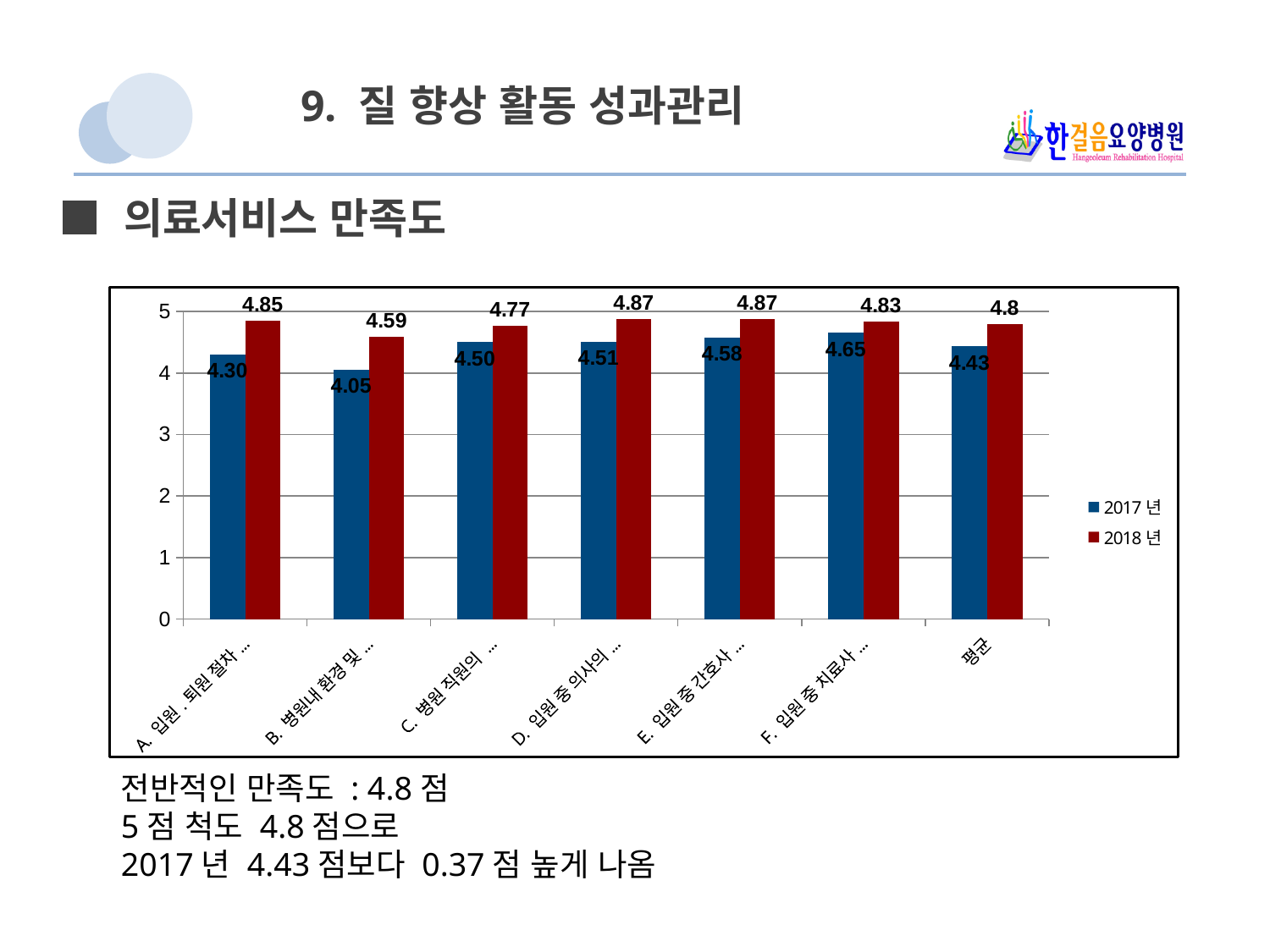
What is the 2018 년 value for 평균? 4.8 Which category has the lowest 2017 년 value? B. 병원내 환경 및 ... How many series does the legend list? 2 For category A (입원·퇴원 절차 ...), which series has the larger value, 2017 년 or 2018 년? 2018 년 What is the 2017 년 value for category B (병원내 환경 및 ...)? 4.05 Is the 2017 년 value for category A (입원·퇴원 절차 ...) greater or less than 5? less Which category has the highest 2017 년 value? F. 입원 중 치료사 ... What is the 2017 년 value for 평균? 4.43 What is the 2018 년 value for category C (병원 직원의 ...)? 4.77 What kind of chart is shown on the slide? bar chart How many categories are shown on the x axis? 7 What is the difference between the 2018 년 and 2017 년 values for 평균? 0.37